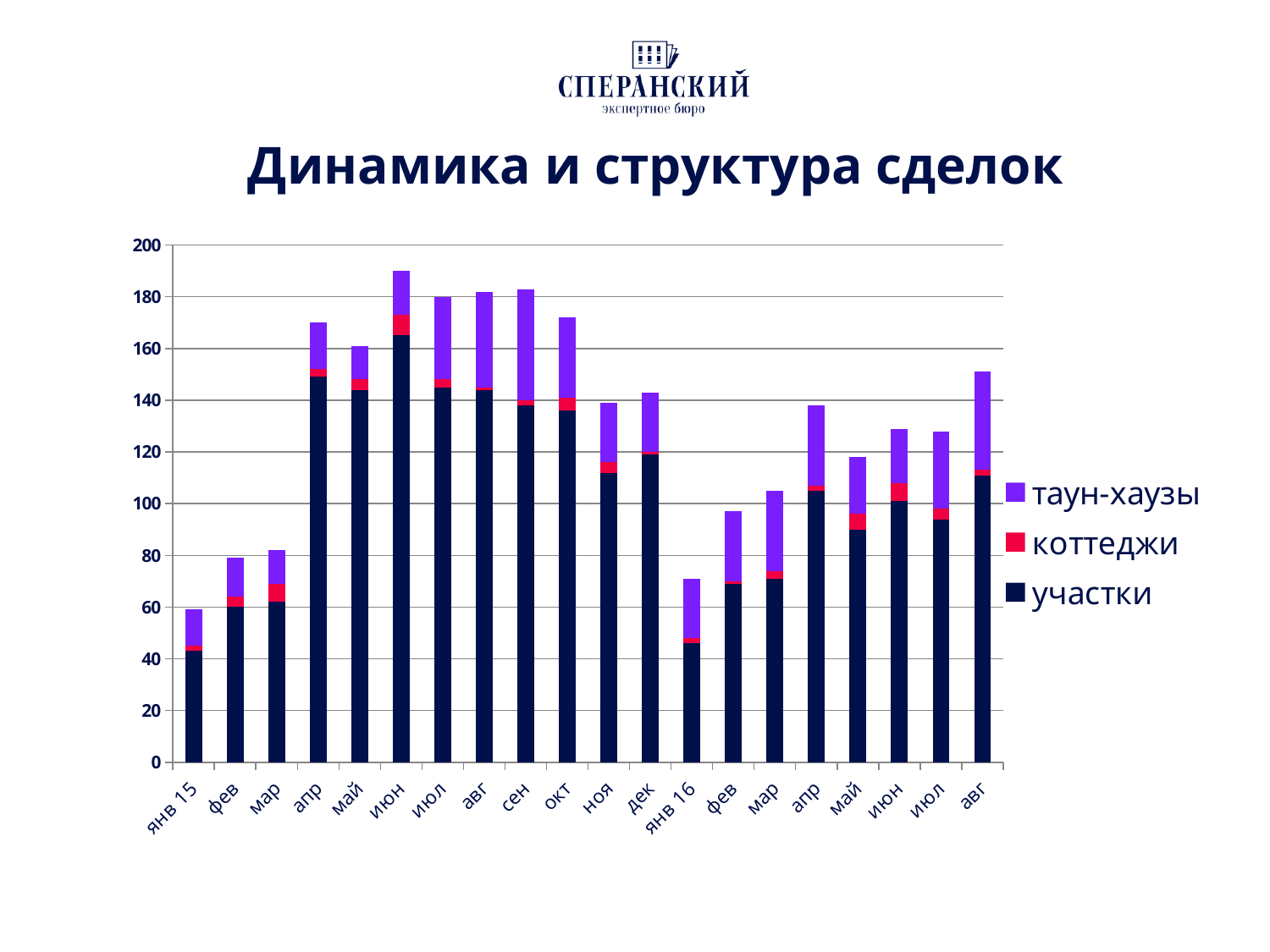
Which month has the lowest total bar? янв 15 Which series is shown in purple in the legend? таун-хаузы Which has the larger total bar, апр 2015 or май 2015? апр 2015 Is the total for янв 16 greater or less than 80? less How many months (categories) are plotted along the x axis? 20 Is the total for июн 2015 greater or less than 180? greater What kind of chart is shown on the slide? stacked bar chart Is the участки value for апр 2015 greater or less than 140? greater Which month has the highest total bar? июн (2015) How many series does the legend list? 3 Do the total bars rise or fall from янв 15 to апр 2015? rise Which has the larger total bar, июл 2016 or авг 2016? авг 2016